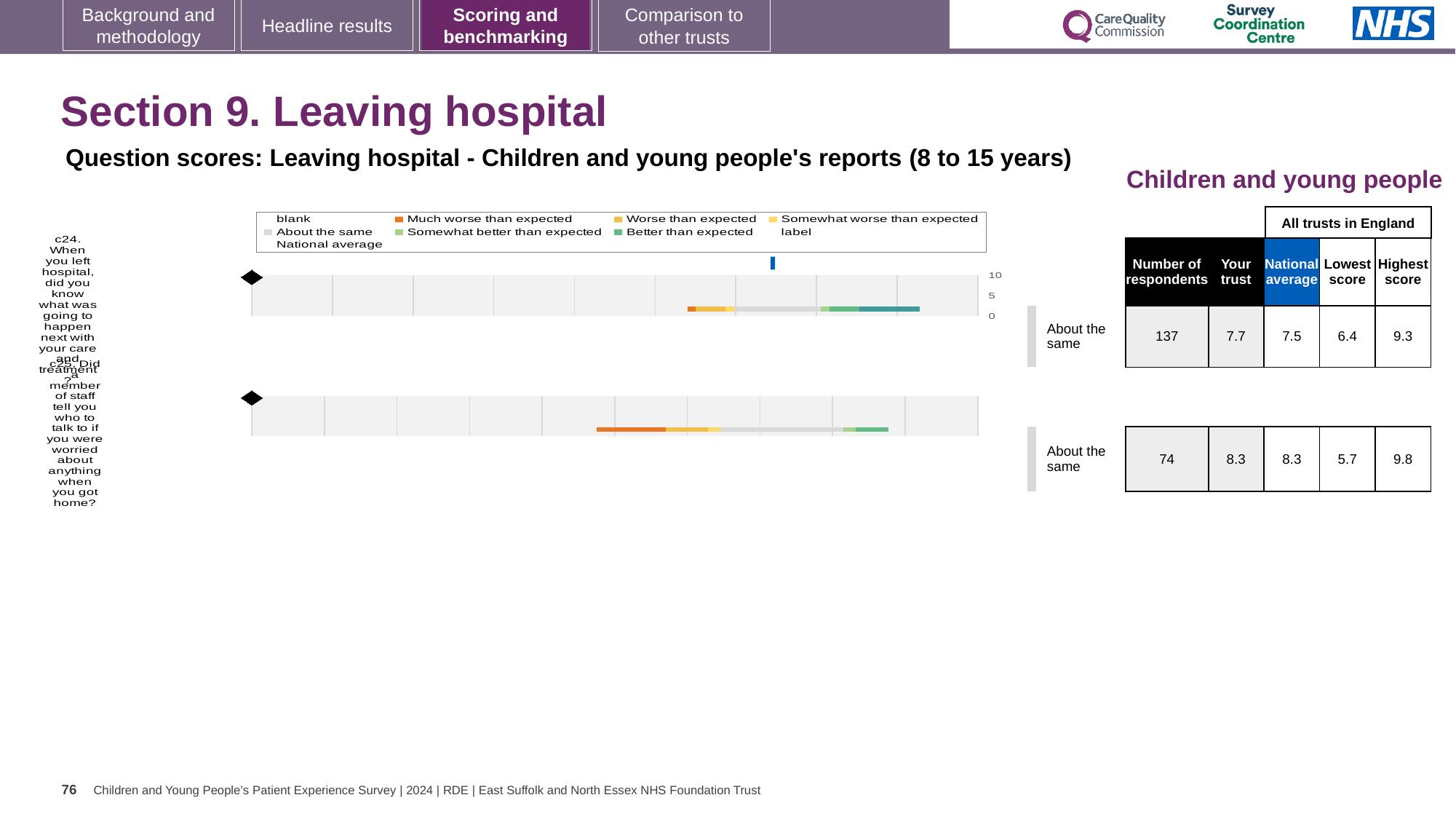
For question c24, is the 'Your trust' score or the national average score larger? Your trust Which legend entry is shown in orange in the chart legend? Much worse than expected Which question has the lower number of respondents, c24 or c25? c25 What kind of chart is used to show the question scores on this slide? bar chart What is the national average score for question c24 in the table next to the chart? 7.5 What is the difference between the highest score and the lowest score for question c24? 2.9 What benchmark category is given for both questions c24 and c25? About the same How many questions (bars) are plotted in the chart? 2 What is the 'Your trust' score for question c25 in the table next to the chart? 8.3 What is the highest score across all trusts in England for question c25? 9.8 What is the maximum value shown on the chart's axis scale? 10 How many respondents are listed for question c24 in the table next to the chart? 137